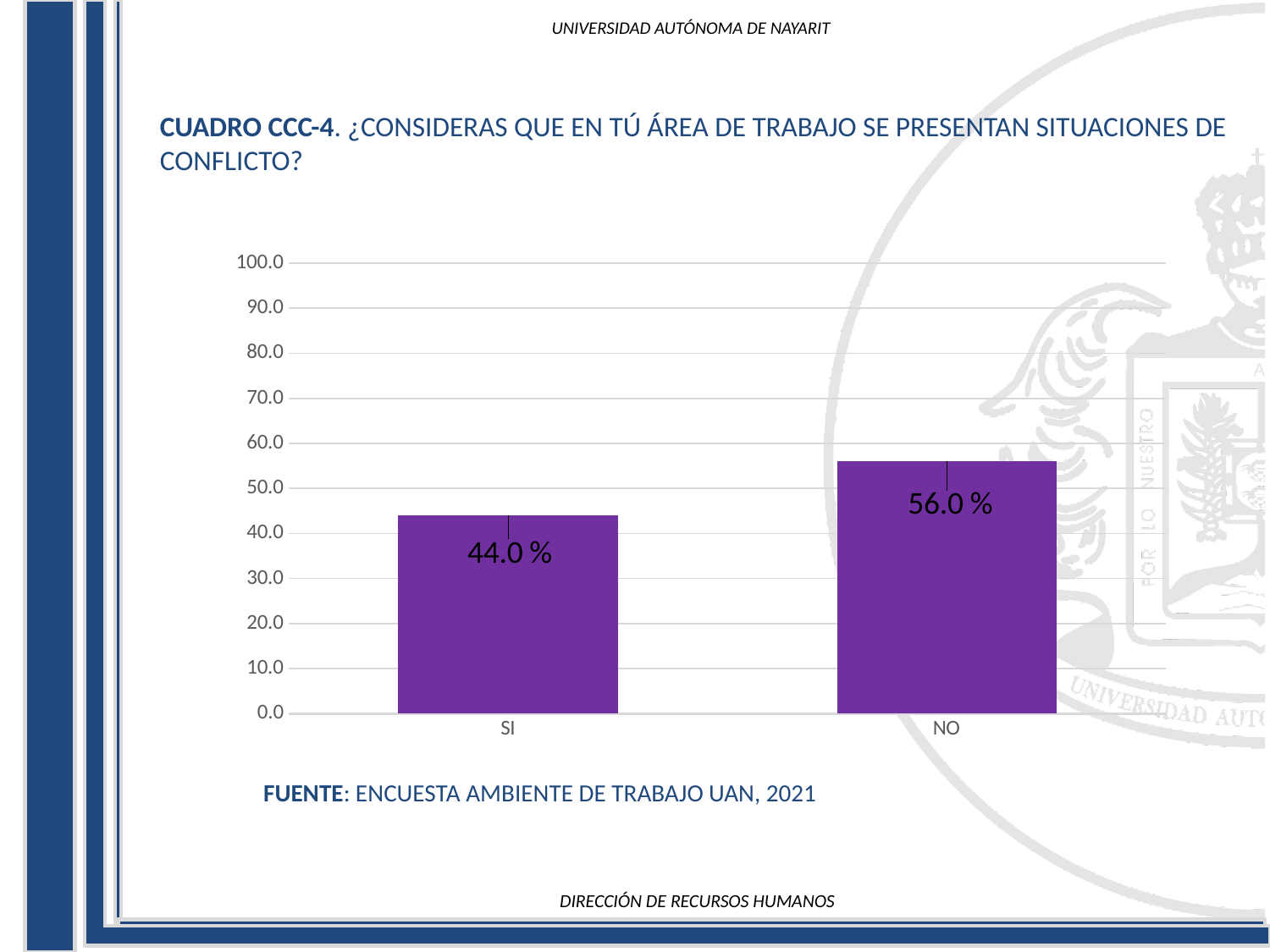
Which is larger, the value for SI or the value for NO? NO Is the value for SI greater or less than 50.0? less What is the source cited below the chart? ENCUESTA AMBIENTE DE TRABAJO UAN, 2021 What is the value for NO? 56.0 % What is the highest value shown on the y axis? 100.0 Which category has the lowest value? SI What kind of chart is shown on the slide? bar chart Is the value for NO greater or less than 50.0? greater What is the difference between the values for NO and SI? 12.0 % How many categories are shown on the x axis? 2 What is the value for SI? 44.0 % Which category has the highest value? NO